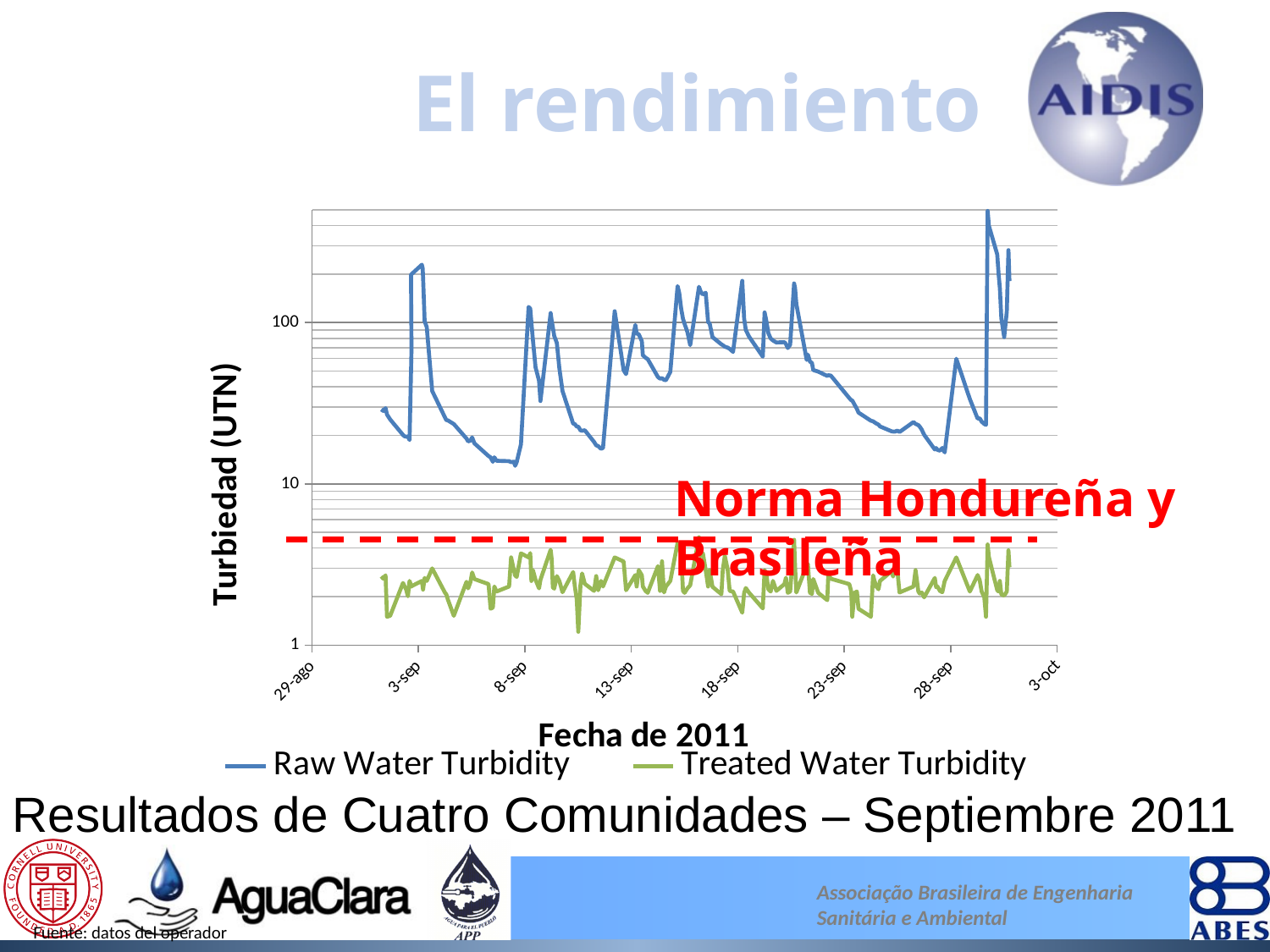
Which series contains the lowest value on the chart? Treated Water Turbidity What are the two series named in the chart legend? Raw Water Turbidity and Treated Water Turbidity What kind of chart is shown on the slide? line chart How many series does the chart legend list? 2 Does the Treated Water Turbidity series ever rise above 10 on the chart? No Is the Raw Water Turbidity value on 18-sep greater or less than 10? greater Is the Treated Water Turbidity value on 13-sep greater or less than 10? less Which series reaches the highest value on the chart? Raw Water Turbidity Which series has higher values throughout the chart, Raw Water Turbidity or Treated Water Turbidity? Raw Water Turbidity What is the label of the vertical axis of the chart? Turbiedad (UTN)